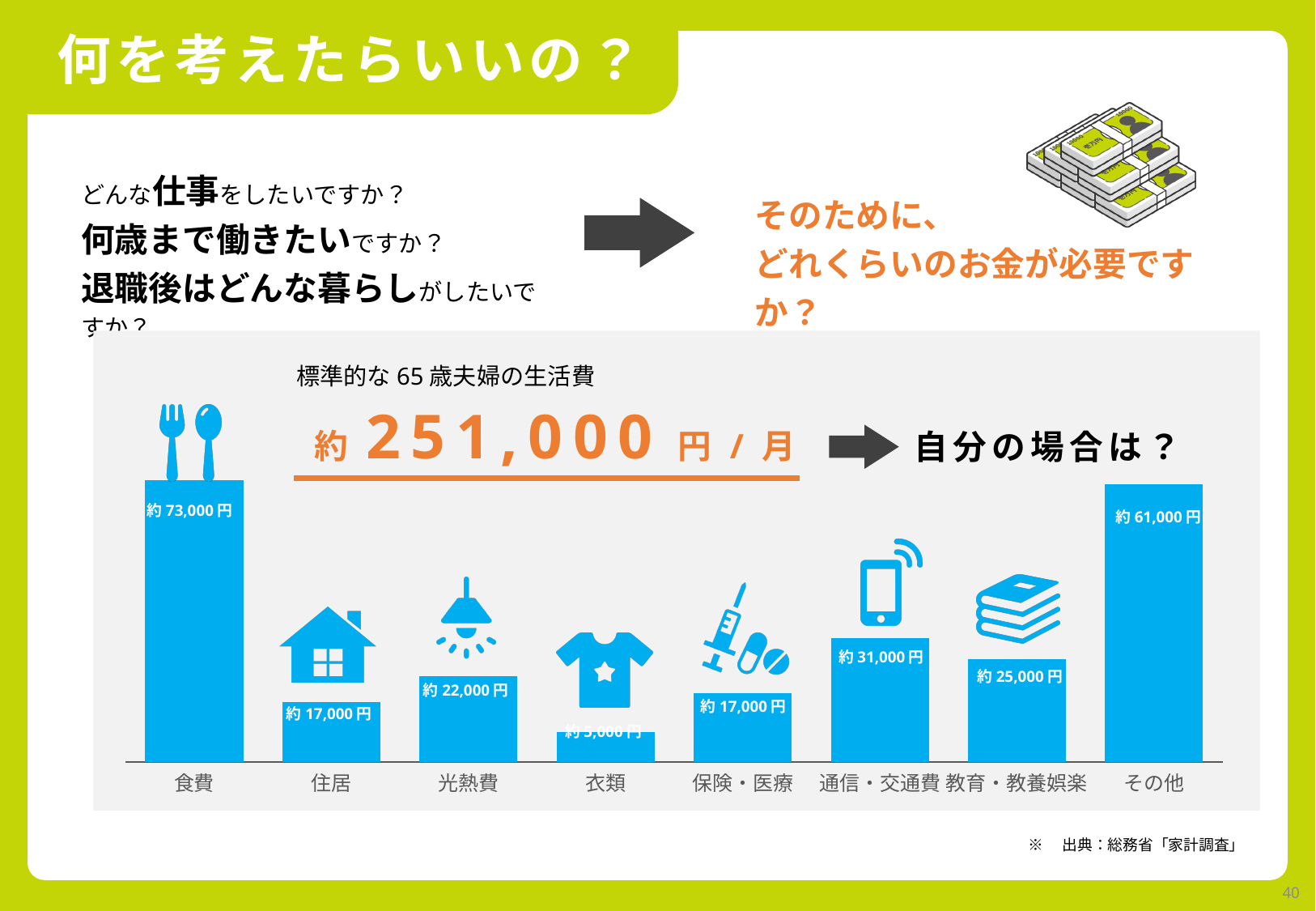
What is the value shown for その他? 約 61,000 円 What is the value shown for 教育・教養娯楽? 約 25,000 円 Which is larger, 通信・交通費 or 教育・教養娯楽? 通信・交通費 How many categories are shown in the chart? 8 What is the value shown for 光熱費? 約 22,000 円 What kind of chart is shown on the slide? bar chart Which category has the lowest value? 衣類 Which category has the highest value? 食費 What is the value shown for 通信・交通費? 約 31,000 円 What monthly total is printed above the chart for a standard 65-year-old couple's living expenses? 約 251,000 円 / 月 What is the value shown for 食費? 約 73,000 円 What is the difference between the values for 食費 and その他? 12,000 円